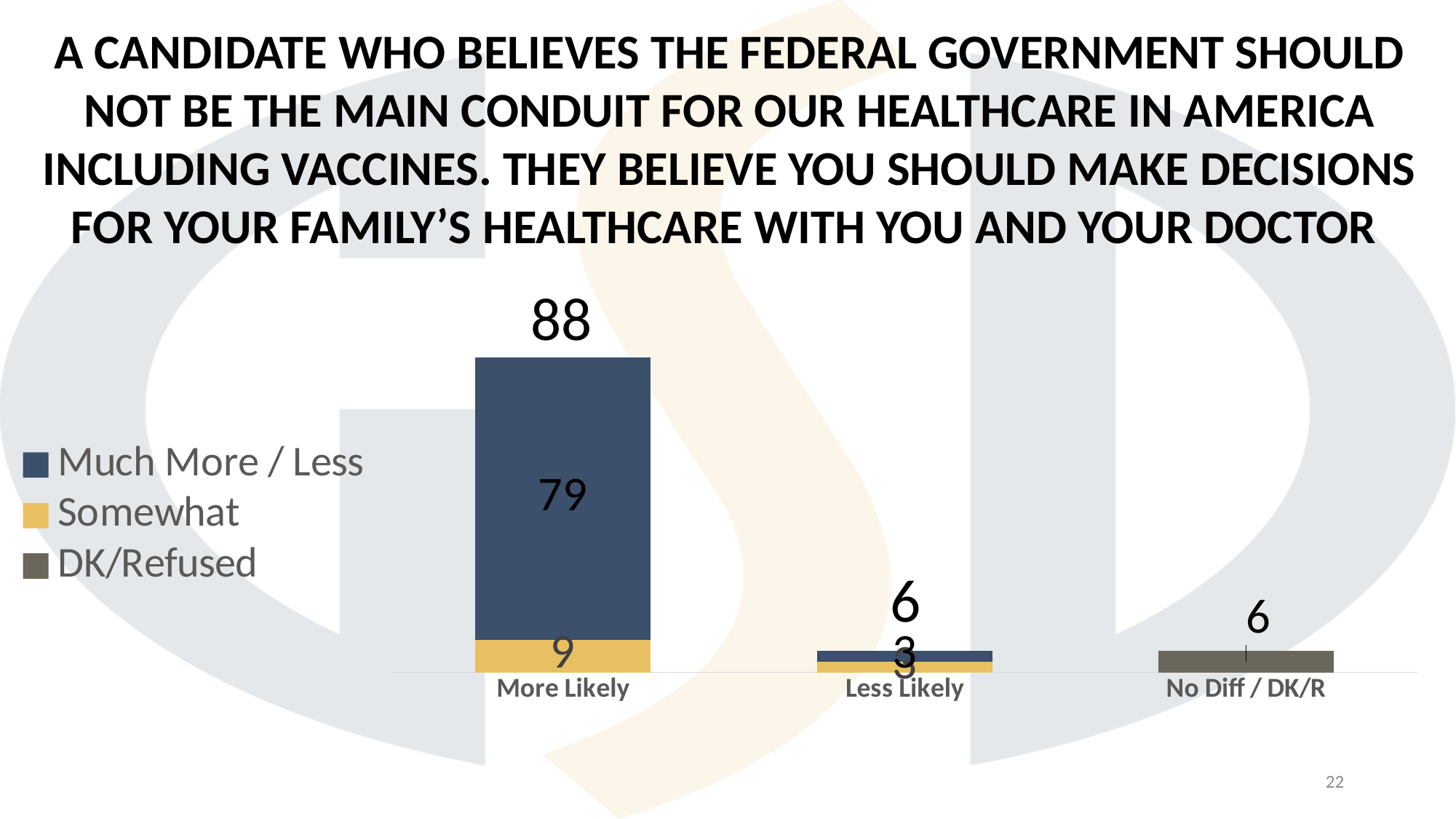
What is the Much More / Less value for More Likely? 79 How many series does the legend list? 3 Which category has the highest total? More Likely What is the total value shown above the Less Likely bar? 6 How many categories are shown on the x axis? 3 What is the value for No Diff / DK/R? 6 Which legend entry is shown in gold/yellow? Somewhat What kind of chart is shown on the slide? Stacked bar chart What is the total value shown above the More Likely bar? 88 What is the Somewhat value for More Likely? 9 What is the difference between the More Likely total and the Less Likely total? 82 Within the More Likely bar, which is larger: Much More / Less or Somewhat? Much More / Less